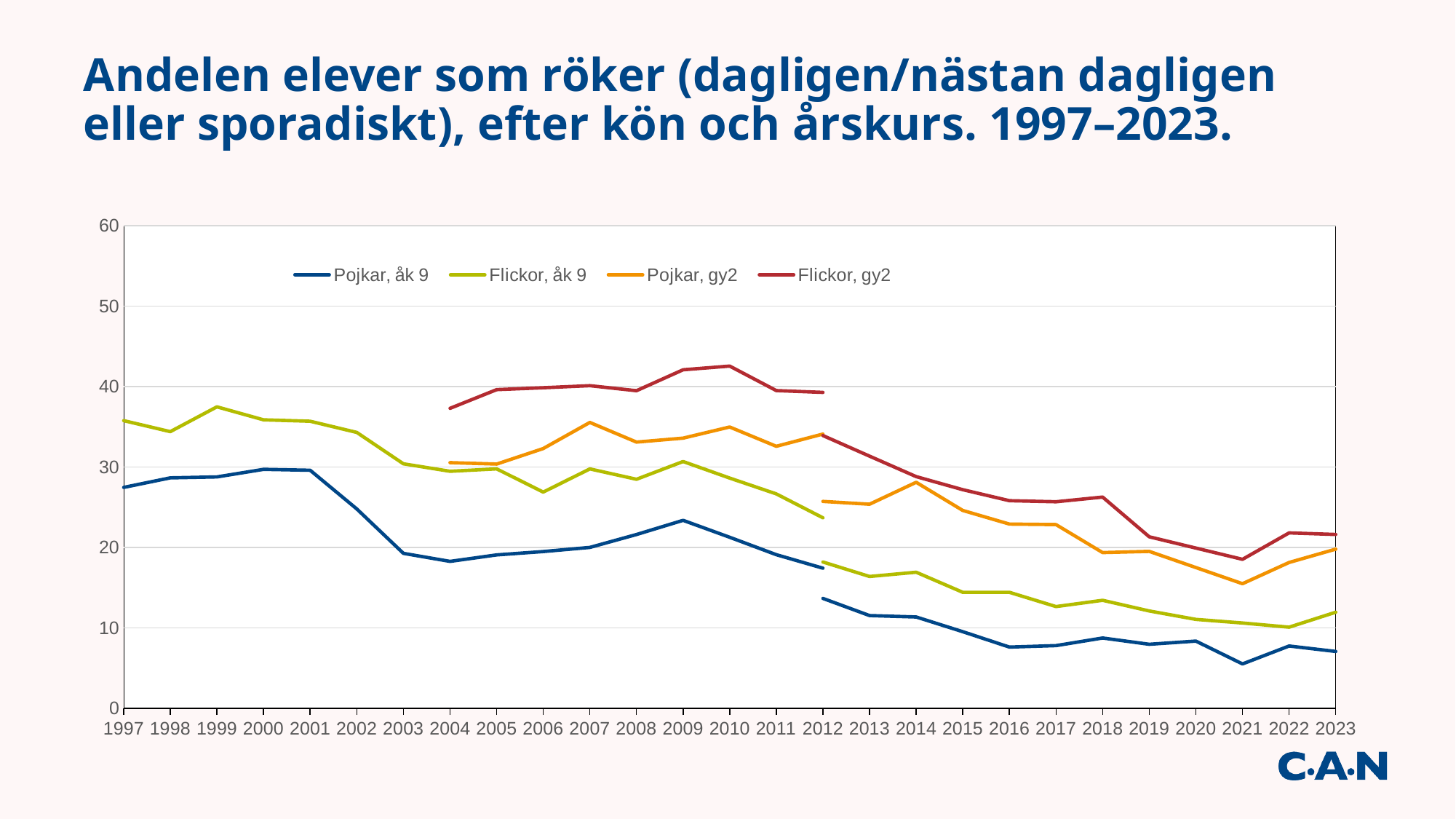
Is the value for Flickor, gy2 in 2010 greater or less than 40? greater Is the value for Flickor, åk 9 in 1999 greater or less than 30? greater In 2023, which is larger: the value for Flickor, gy2 or the value for Pojkar, åk 9? Flickor, gy2 How many years are shown on the x axis? 27 Is the value for Pojkar, åk 9 in 2021 greater or less than 10? less Which series has the highest value in 2010? Flickor, gy2 How many series does the legend list? 4 Which series has the lowest value in 2023? Pojkar, åk 9 Does the Pojkar, åk 9 line rise or fall overall from 1997 to 2023? Fall What kind of chart is shown on the slide? Line chart In which year do the gy2 series first appear on the chart? 2004